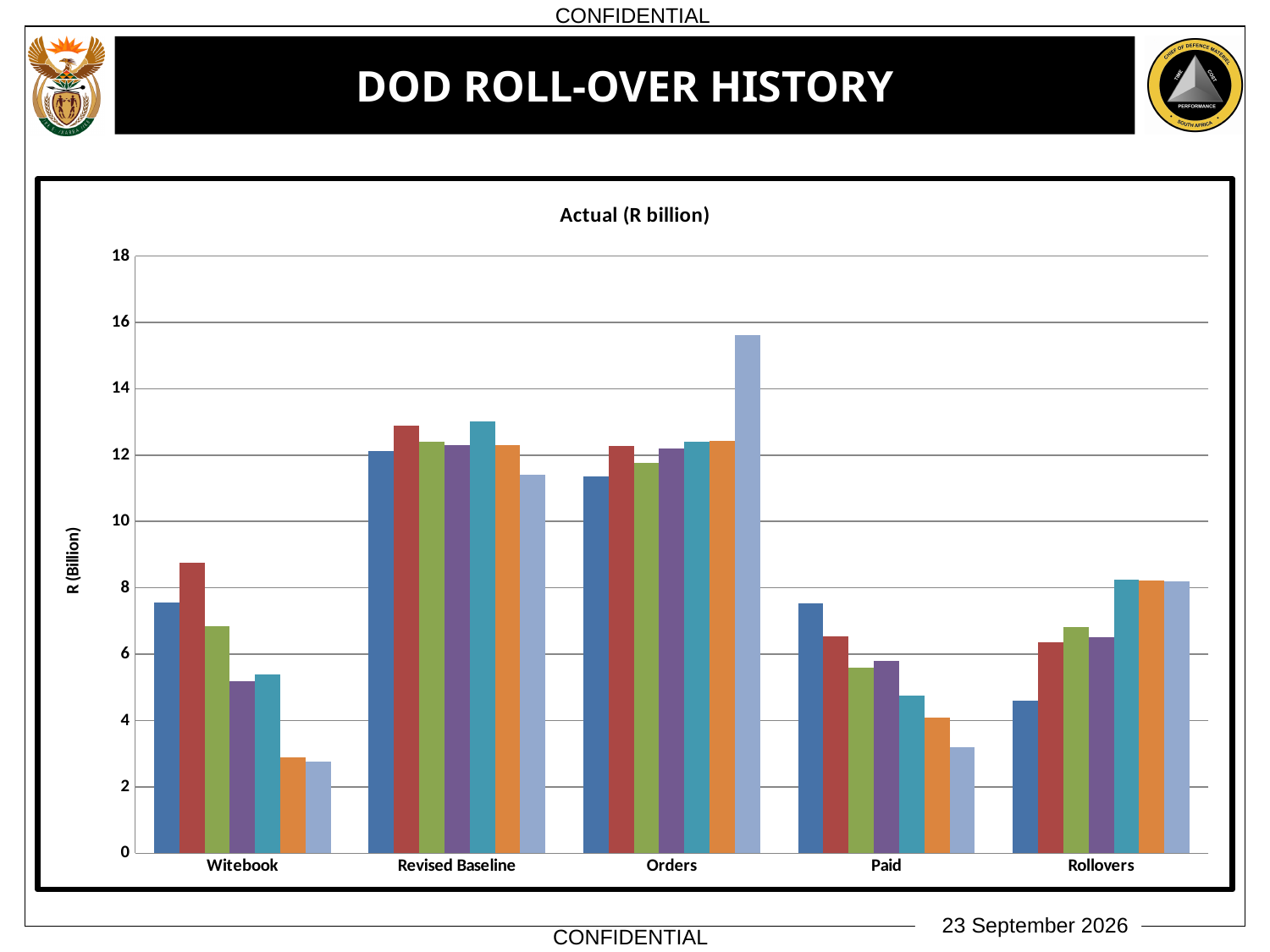
What is the title of the chart? Actual (R billion) Is the last (light blue) bar for Witebook greater or less than 4? less Which category contains the shortest bar in the chart? Witebook What is the label on the vertical axis of the chart? R (Billion) Is the tallest bar in the Orders category greater or less than 14? greater Is the first (dark blue) bar for Witebook greater or less than 8? less How many bars are plotted for each category in the chart? 7 Which category contains the tallest bar in the chart? Orders In the Paid category, is the first (dark blue) bar taller or shorter than the last (light blue) bar? taller What kind of chart is shown on the slide? bar chart How many categories are shown along the x axis of the chart? 5